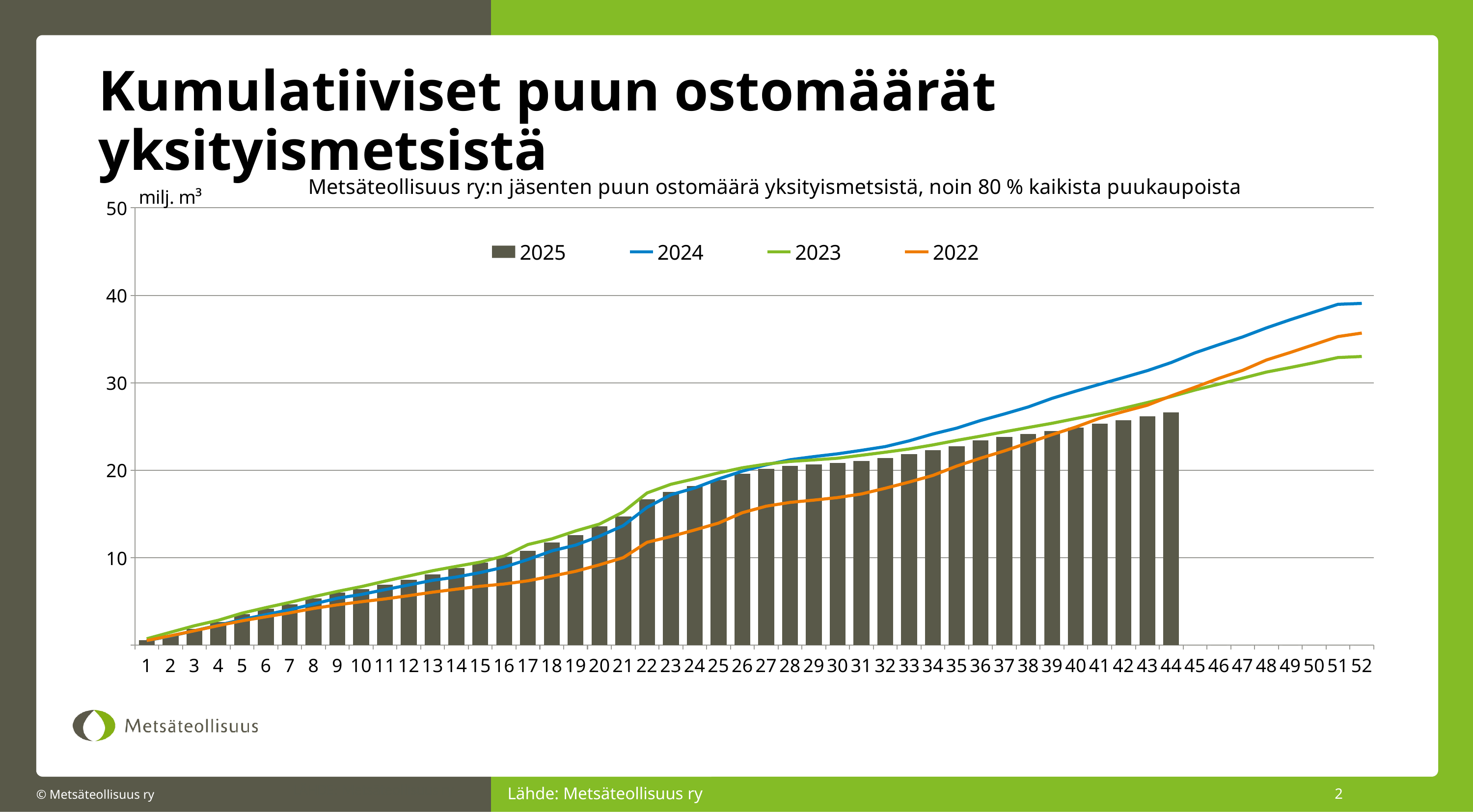
At week 30, which is larger: the 2023 line or the 2022 line? 2023 Is the 2023 line value at week 52 greater or less than 30? greater Is the 2025 bar at week 44 greater or less than 30? less What kind of chart is this? Combined bar and line chart Which series has the lowest value at week 52? 2023 How many week categories are shown on the x axis? 52 Which series has the highest value at week 52? 2024 Is the 2025 bar at week 44 greater or less than 20? greater How many bars are plotted for the 2025 series? 44 Do the values rise or fall along the x axis? rise How many series does the legend list? 4